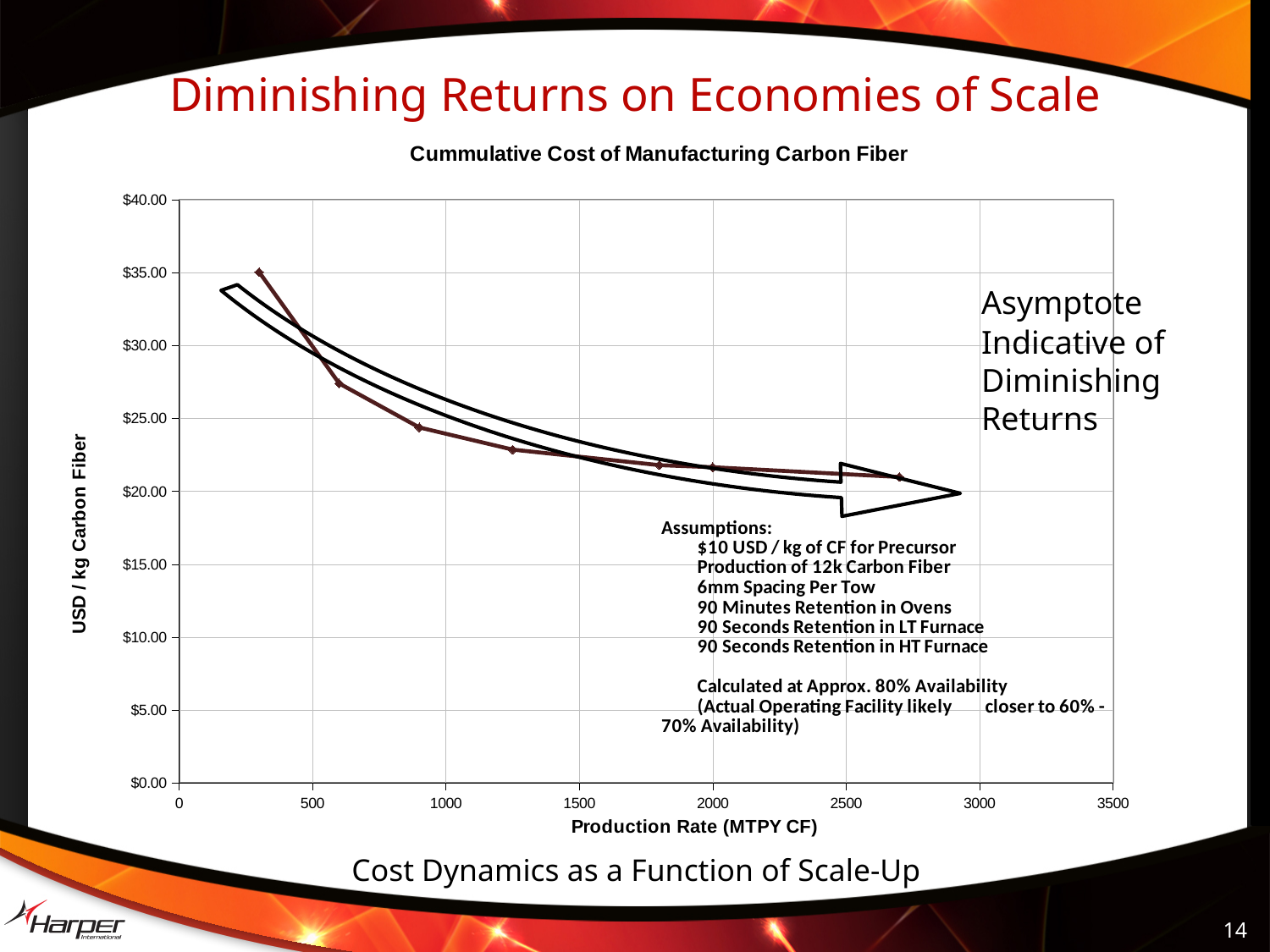
Is the cost at a production rate of about 1250 MTPY greater or less than $25.00? less What is the title of the chart? Cummulative Cost of Manufacturing Carbon Fiber What is the maximum value shown on the x axis? 3500 What is the label of the y axis? USD / kg Carbon Fiber Is the cost at the lowest plotted production rate (about 300 MTPY) greater or less than $30.00? greater Is the cost at the highest plotted production rate (about 2700 MTPY) greater or less than $25.00? less Which plotted point has the highest cost per kg: the one at the lowest production rate or the one at the highest production rate? The one at the lowest production rate Does the cost per kg rise or fall as the production rate increases? Fall Is the cost at about 600 MTPY higher or lower than the cost at about 1800 MTPY? Higher What kind of chart is shown on the slide? Line chart